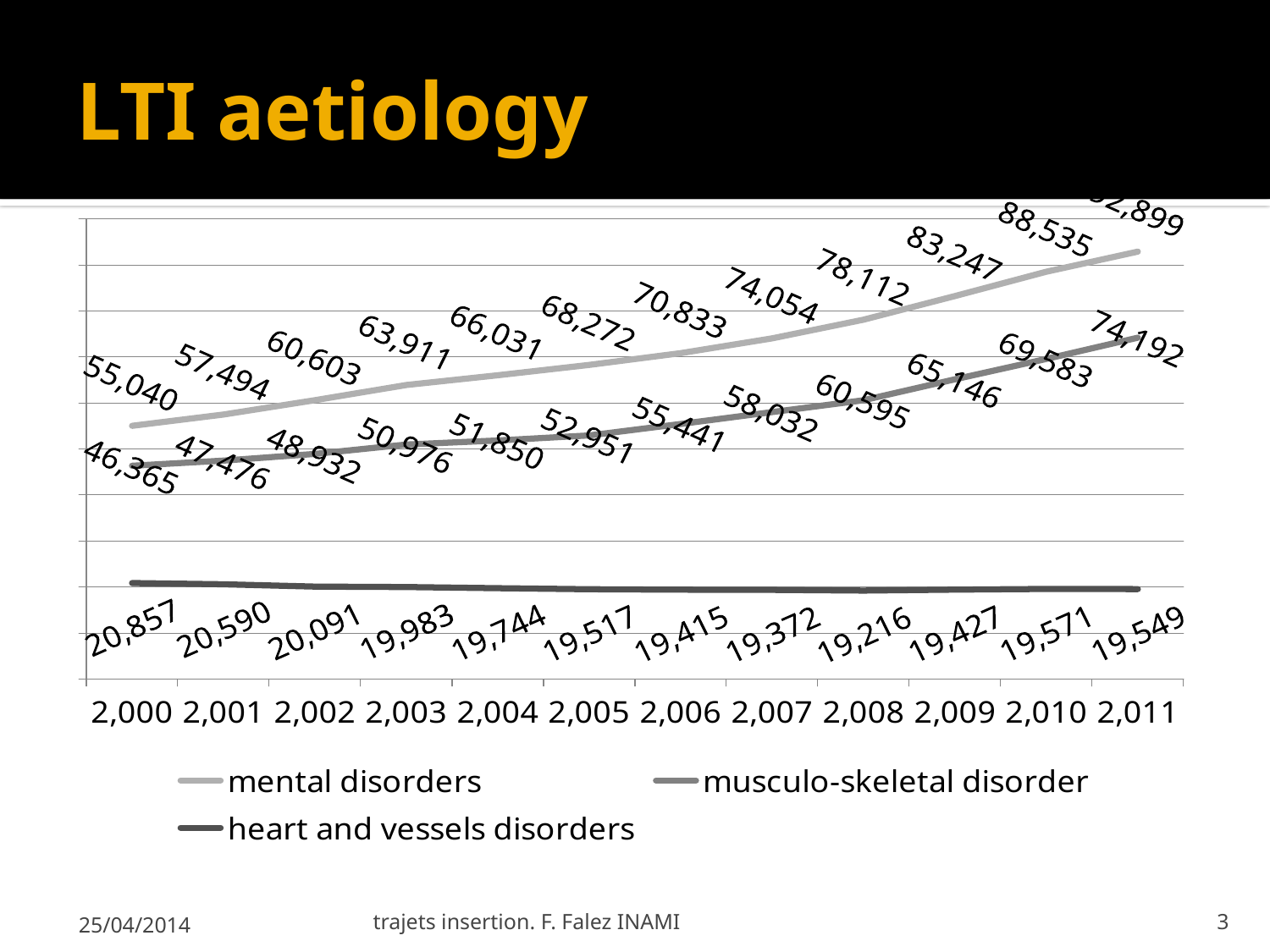
In which year is the musculo-skeletal disorder value highest? 2,011 In which year is the heart and vessels disorders value lowest? 2,008 Which series is drawn with the darkest line? heart and vessels disorders How many years are plotted along the x axis? 12 What is the difference between the mental disorders value in 2,010 and in 2,009? 5,288 How many series does the legend list? 3 What is the value for mental disorders in 2,000? 55,040 Which is larger in 2,007: the mental disorders value or the musculo-skeletal disorder value? mental disorders What is the value for musculo-skeletal disorder in 2,011? 74,192 Does the mental disorders series rise or fall from 2,000 to 2,011? rise What is the value for heart and vessels disorders in 2,005? 19,517 What type of chart is shown on the slide? line chart